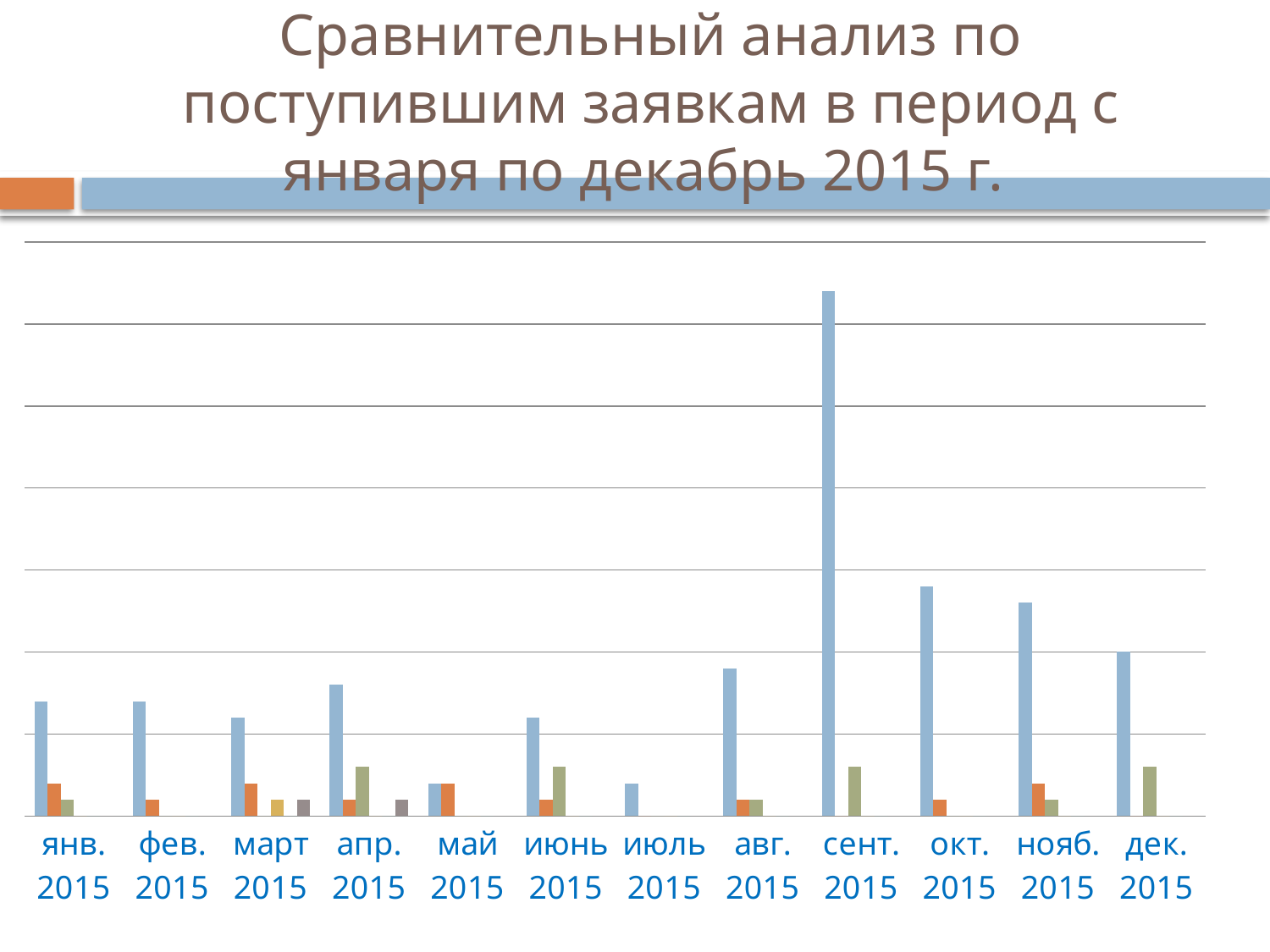
Which month has the taller blue bar, май 2015 or июнь 2015? июнь 2015 Do the blue bars rise or fall from сент. 2015 to дек. 2015? fall What is the title of the chart on the slide? Сравнительный анализ по поступившим заявкам в период с января по декабрь 2015 г. Which month has the taller blue bar, июль 2015 or авг. 2015? авг. 2015 What is the first category label on the x axis? янв. 2015 How many months (categories) are shown on the x axis? 12 Which month has the taller blue bar, сент. 2015 or окт. 2015? сент. 2015 What kind of chart is shown on the slide? bar chart In which month is the tallest blue bar? сент. 2015